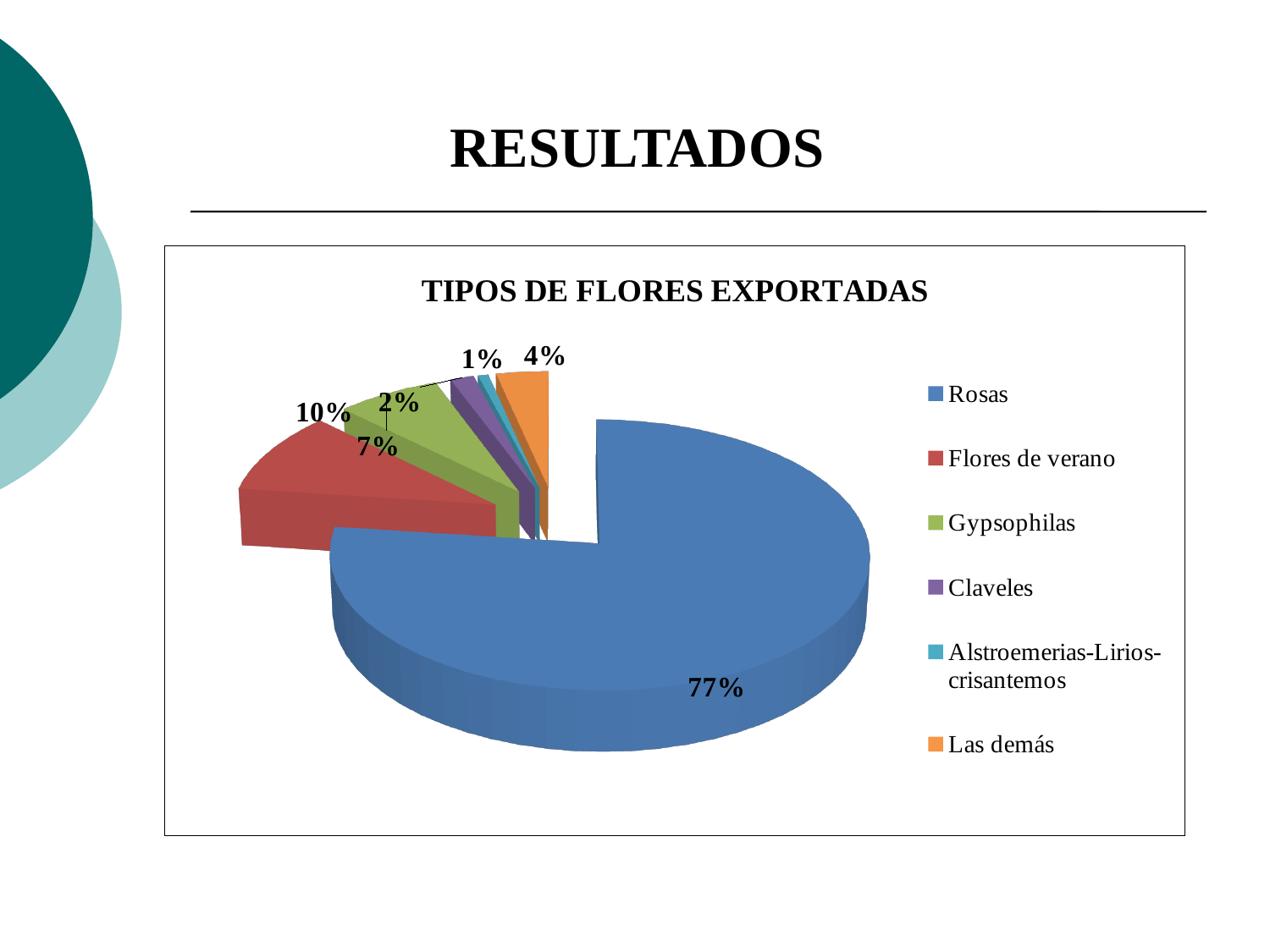
How many categories does the legend list? 6 What kind of chart is shown on the slide? Pie chart What share of the pie does Flores de verano represent? 10% Which category has the smallest slice of the pie? Alstroemerias-Lirios-crisantemos What is the difference between the shares of Rosas and Flores de verano? 67% What share of the pie does Las demás represent? 4% What is the title of the chart? TIPOS DE FLORES EXPORTADAS Which category has the largest slice of the pie? Rosas What share of the pie does Rosas represent? 77% Which is larger, the share of Gypsophilas or the share of Las demás? Gypsophilas